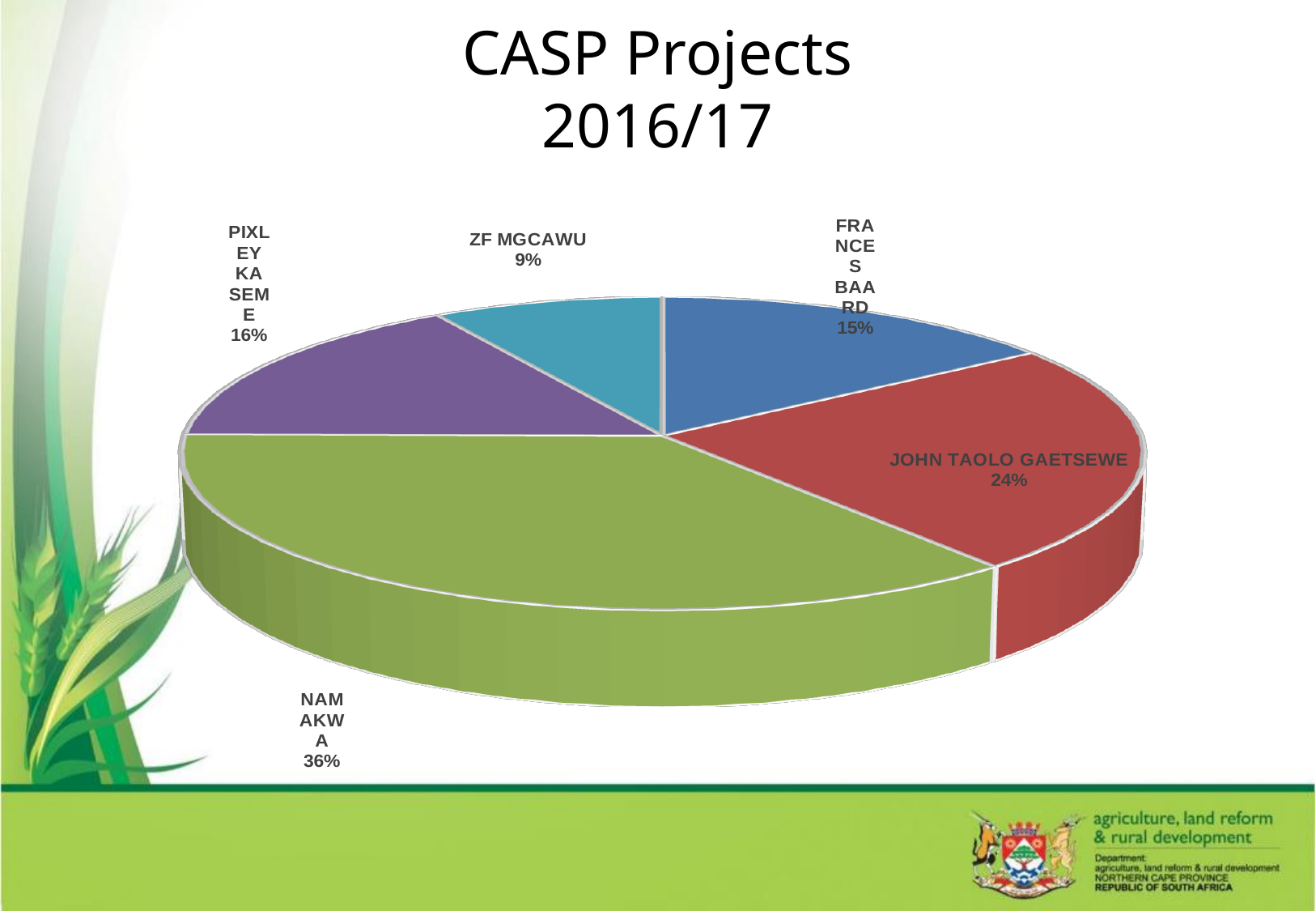
What share of CASP Projects 2016/17 does Namakwa account for? 36% What is the title of the chart? CASP Projects 2016/17 How many slices does the pie chart have? 5 What percentage is shown for ZF Mgcawu? 9% Which district has the smallest share of the pie? ZF Mgcawu What is the difference in percentage points between Namakwa and John Taolo Gaetsewe? 12 What percentage is shown for Frances Baard? 15% What percentage is shown for Pixley Ka Seme? 16% What percentage is shown for John Taolo Gaetsewe? 24% What kind of chart is shown on the slide? Pie chart Which district has the largest share of the pie? Namakwa Which has a larger share, Frances Baard or Pixley Ka Seme? Pixley Ka Seme